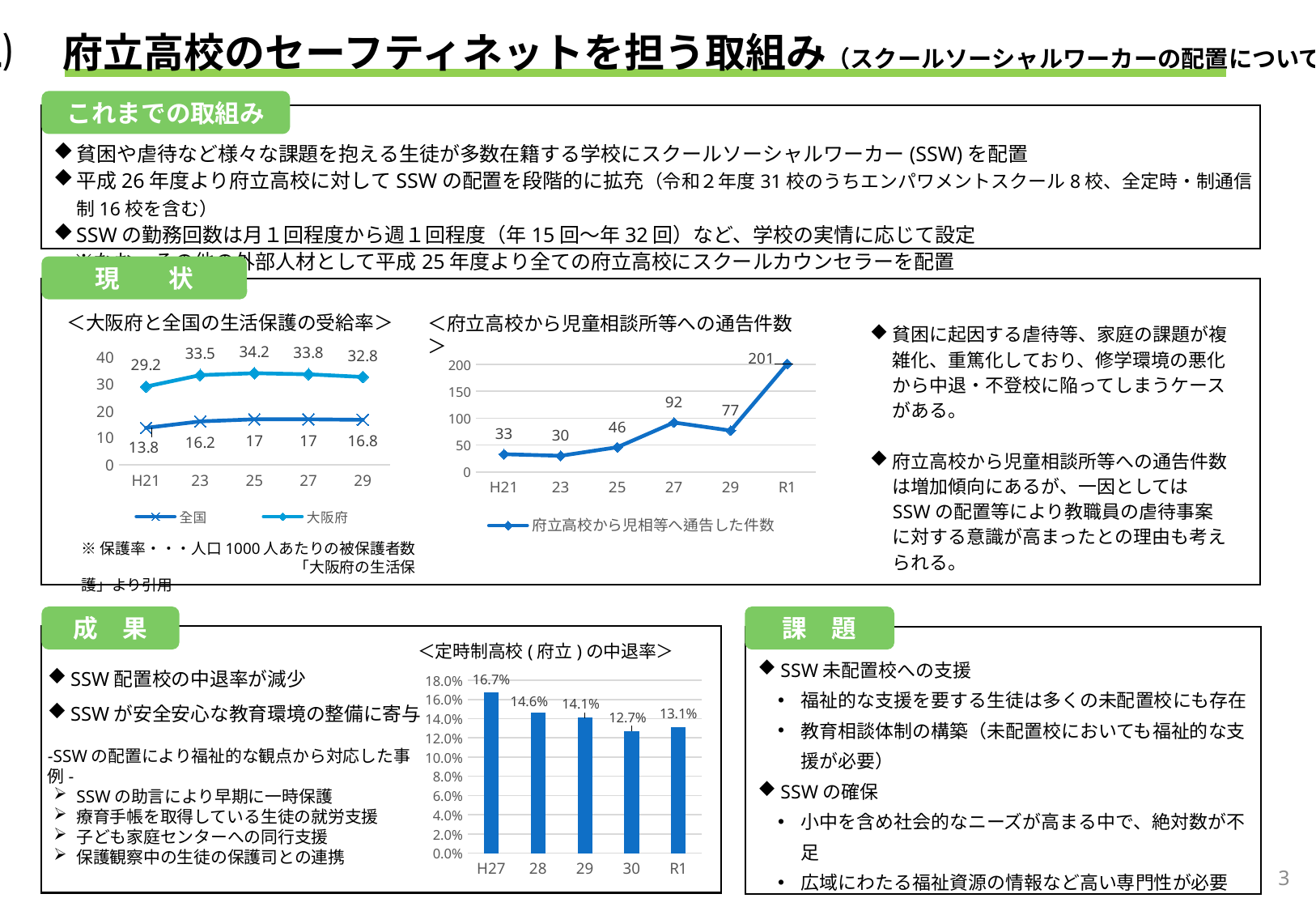
In the chart titled ＜大阪府と全国の生活保護の受給率＞, how many series does the legend list? 2 In the chart titled ＜大阪府と全国の生活保護の受給率＞, what is the value for 大阪府 at 25? 34.2 In the chart titled ＜大阪府と全国の生活保護の受給率＞, which series has the higher value at 29, 全国 or 大阪府? 大阪府 In the chart titled ＜府立高校から児童相談所等への通告件数＞, how many data points are plotted? 6 In the chart titled ＜定時制高校(府立)の中退率＞, what kind of chart is shown? bar chart In the chart titled ＜府立高校から児童相談所等への通告件数＞, which year has the lowest value? 23 In the chart titled ＜定時制高校(府立)の中退率＞, what is the value for 30? 12.7% In the chart titled ＜定時制高校(府立)の中退率＞, which year has the highest value? H27 In the chart titled ＜定時制高校(府立)の中退率＞, what is the difference between the values for H27 and 28? 2.1% In the chart titled ＜府立高校から児童相談所等への通告件数＞, what is the difference between the values for 27 and 29? 15 In the chart titled ＜府立高校から児童相談所等への通告件数＞, what is the value for R1? 201 In the chart titled ＜大阪府と全国の生活保護の受給率＞, what is the value for 全国 at H21? 13.8